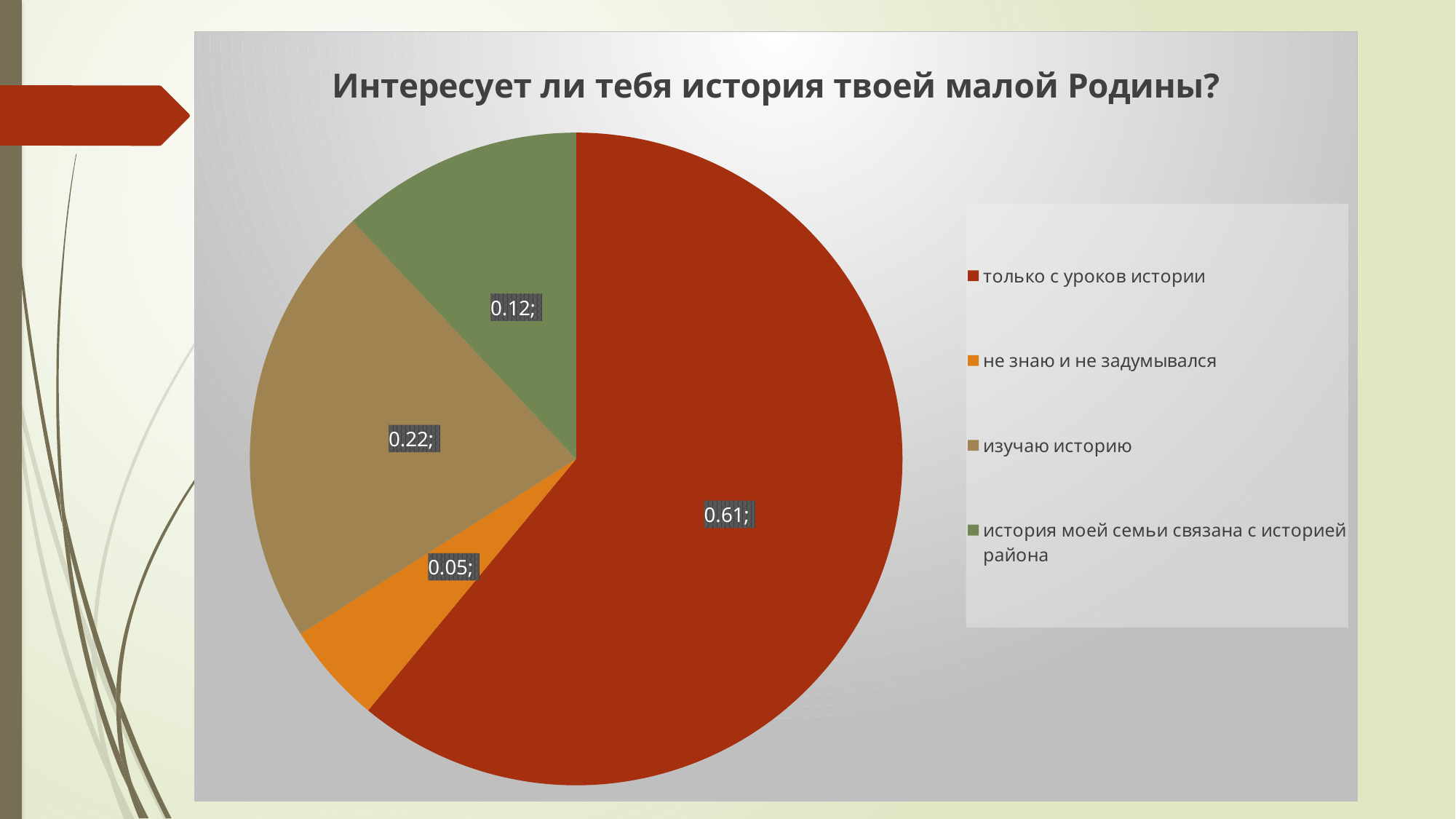
What is the value shown for the slice "история моей семьи связана с историей района"? 0.12 What kind of chart is shown on the slide? pie chart What is the difference between the values for "только с уроков истории" and "изучаю историю"? 0.39 Which category has the smallest slice of the pie? не знаю и не задумывался What is the value shown for the slice "изучаю историю"? 0.22 What is the value shown for the slice "только с уроков истории"? 0.61 Which category is shown in green in the legend? история моей семьи связана с историей района How many slices does the pie chart have? 4 What is the value shown for the slice "не знаю и не задумывался"? 0.05 What is the title of the chart? Интересует ли тебя история твоей малой Родины? Which category has the largest slice of the pie? только с уроков истории Which is larger: the slice for "изучаю историю" or the slice for "история моей семьи связана с историей района"? изучаю историю